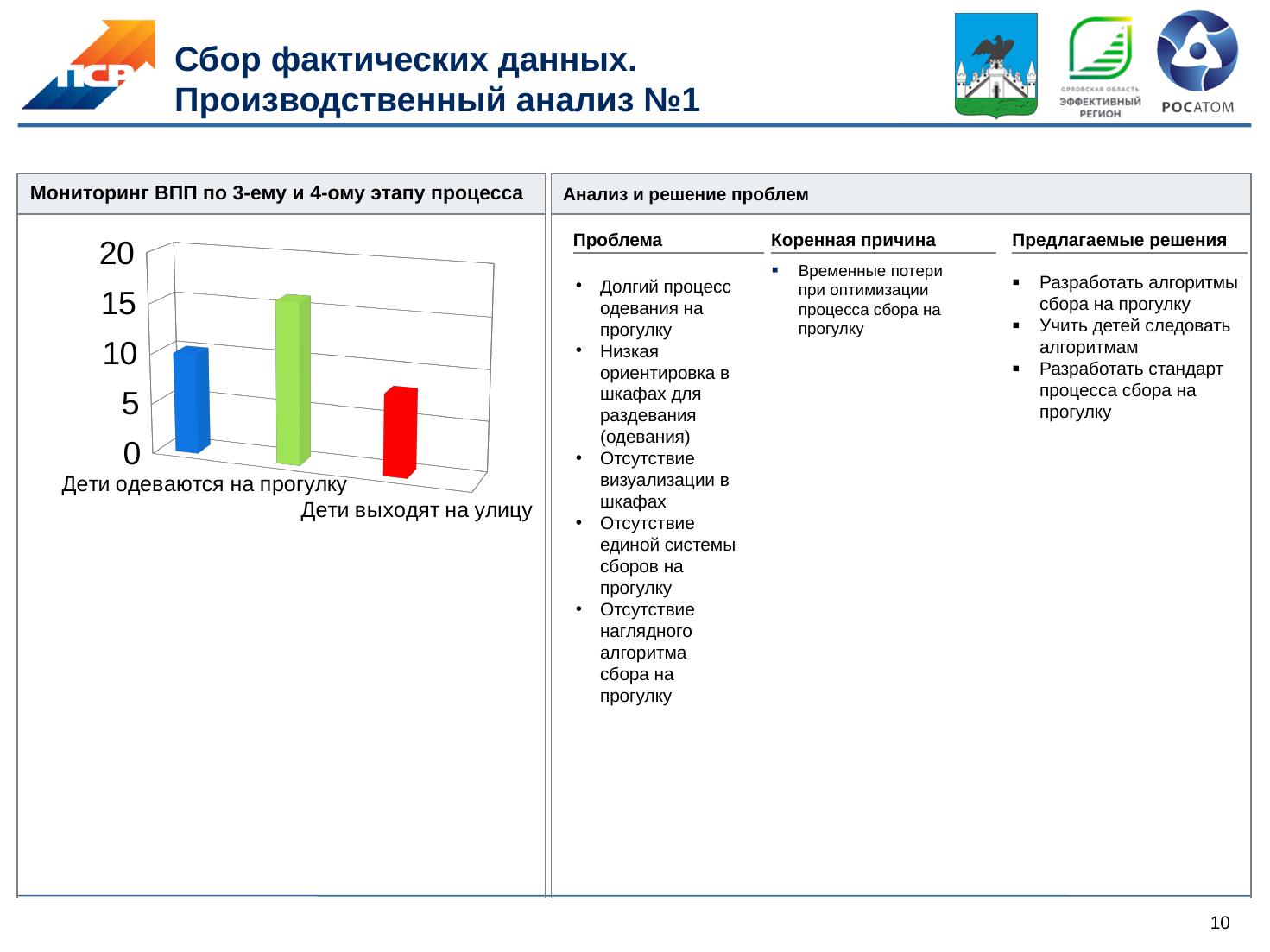
Is the value of the red bar greater or less than 10? less Is the value of the blue bar greater or less than 15? less Which bar is the tallest in the chart? the green bar Is the value of the blue bar greater or less than 5? greater Which is larger, the green bar or the blue bar? the green bar Which bar is the shortest in the chart? the red bar Which is larger, the blue bar or the red bar? the blue bar What is the highest value shown on the vertical axis of the chart? 20 What is the title of the chart panel on the left of the slide? Мониторинг ВПП по 3-ему и 4-ому этапу процесса How many bars are plotted in the chart? 3 What type of chart is shown on the slide? bar chart